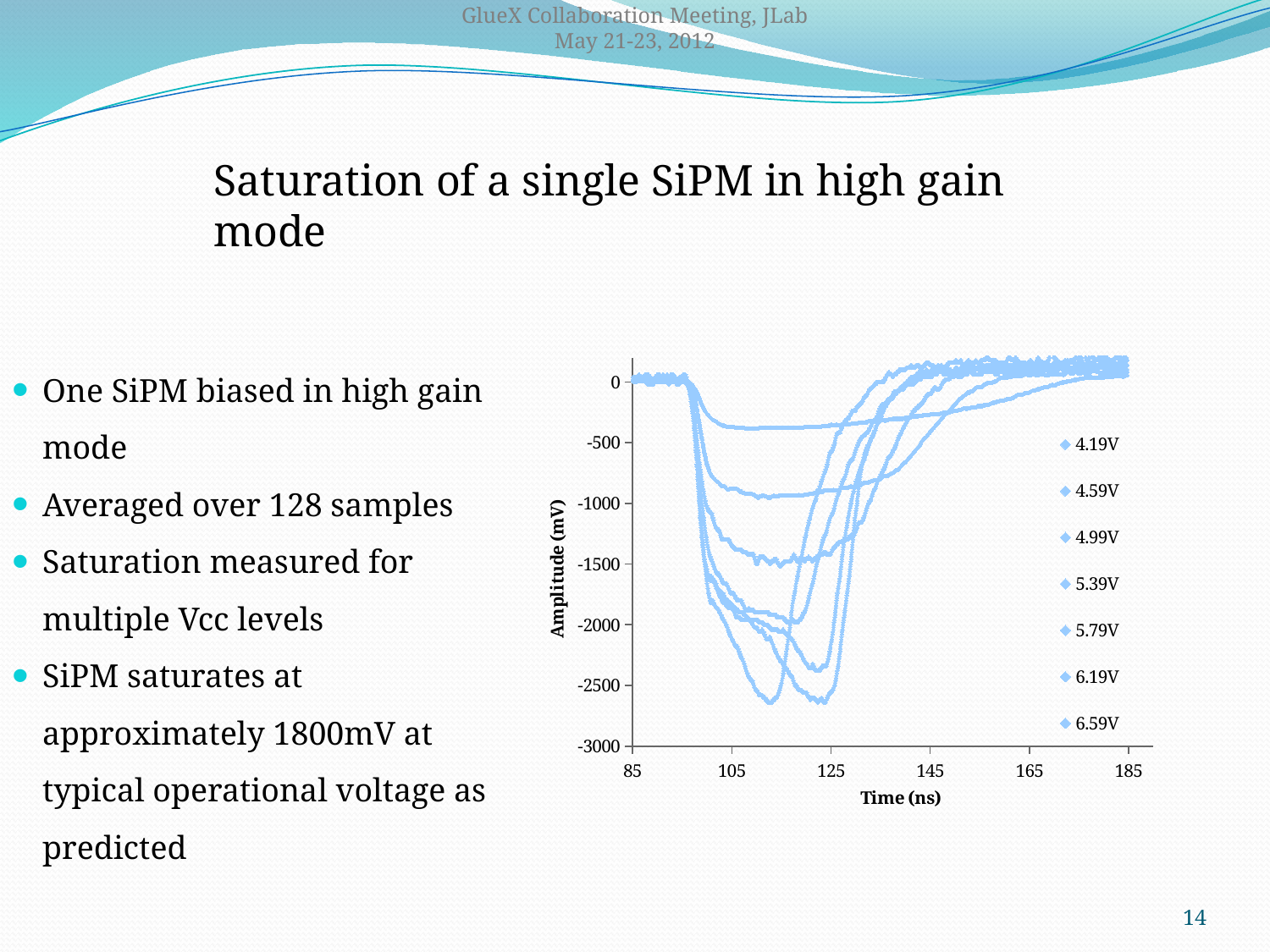
Do the amplitudes on the chart rise or fall sharply just after about 95 ns? fall What kind of chart is shown on the slide? scatter chart Does any curve on the chart reach an amplitude below -3000 mV? no What is the label of the y axis of the chart? Amplitude (mV) How many series does the legend of the chart list? 7 Do the curves on the chart return toward 0 mV by 185 ns? yes Does any curve on the chart reach an amplitude below -2500 mV? yes What is the label of the x axis of the chart? Time (ns)